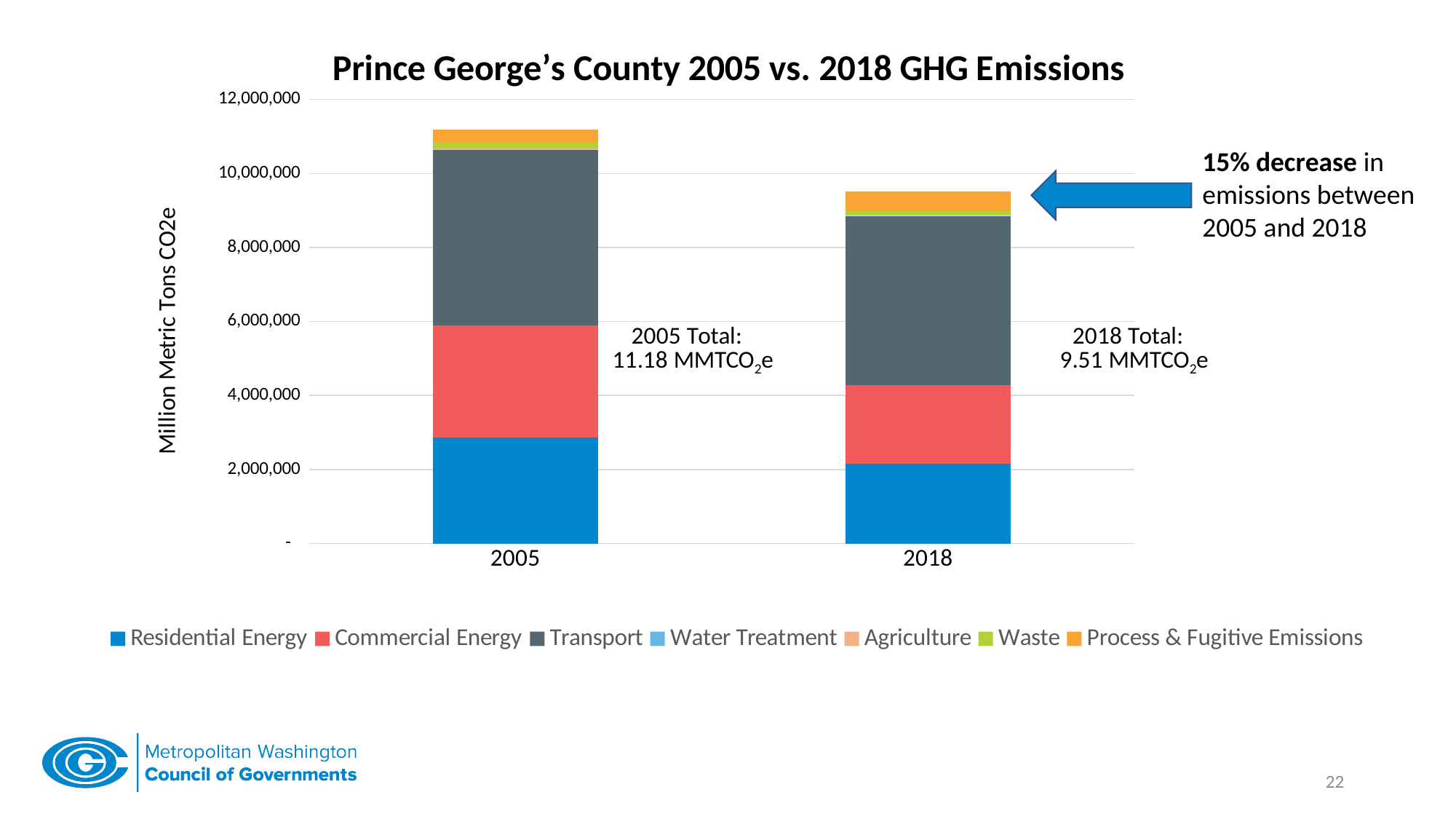
What is the 2018 total emissions value stated on the slide? 9.51 MMTCO2e What is the difference between the 2005 total and the 2018 total? 1.67 MMTCO2e What percentage decrease in emissions between 2005 and 2018 does the slide state? 15% decrease Is the total for the 2018 bar greater or less than 10,000,000? less Do total emissions rise or fall from 2005 to 2018? Fall How many series does the legend list? 7 Which sector is the largest segment of the 2005 bar? Transport What is the 2005 total emissions value stated on the slide? 11.18 MMTCO2e Is the Transport segment in the 2005 bar greater or less than 4,000,000? greater How many years (categories) are plotted on the x axis? 2 Which year has the higher total emissions, 2005 or 2018? 2005 What kind of chart is shown on the slide? Stacked bar chart